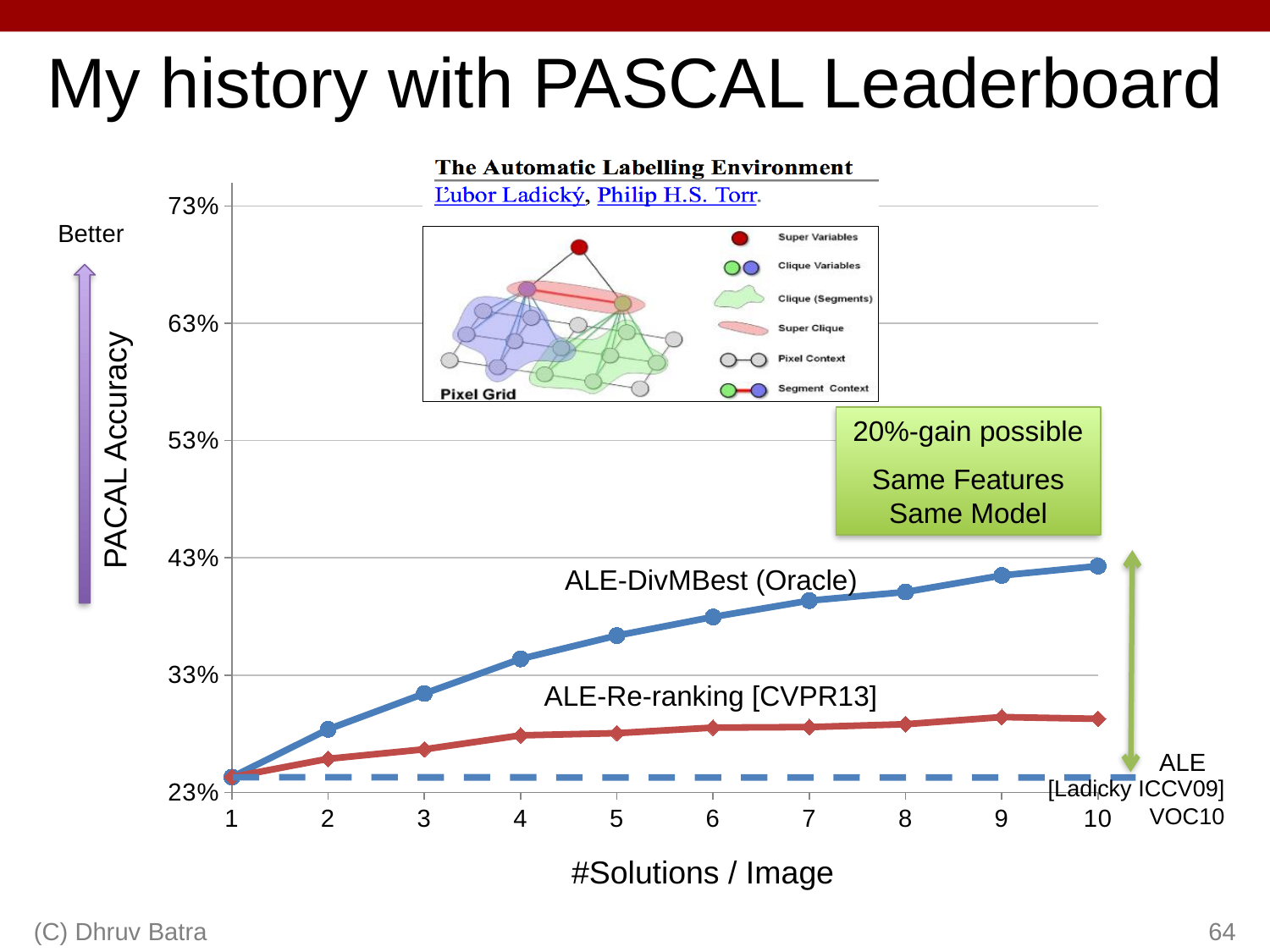
What is the label of the x axis? #Solutions / Image At 10 solutions per image, which line is higher: ALE-DivMBest (Oracle) or ALE-Re-ranking [CVPR13]? ALE-DivMBest (Oracle) What kind of chart is shown on the slide? line chart Is the ALE-Re-ranking [CVPR13] value at 10 solutions per image greater or less than 33%? less Which line reaches the highest PACAL Accuracy on the chart? ALE-DivMBest (Oracle) How many points along the x axis (#Solutions / Image) are plotted for the ALE-DivMBest (Oracle) line? 10 Does the ALE-DivMBest (Oracle) line rise or fall as #Solutions / Image increases from 1 to 10? rise Is the ALE-DivMBest (Oracle) value at 1 solution per image greater or less than 33%? less Is the ALE-DivMBest (Oracle) value at 10 solutions per image greater or less than 33%? greater What is the label of the y axis? PACAL Accuracy